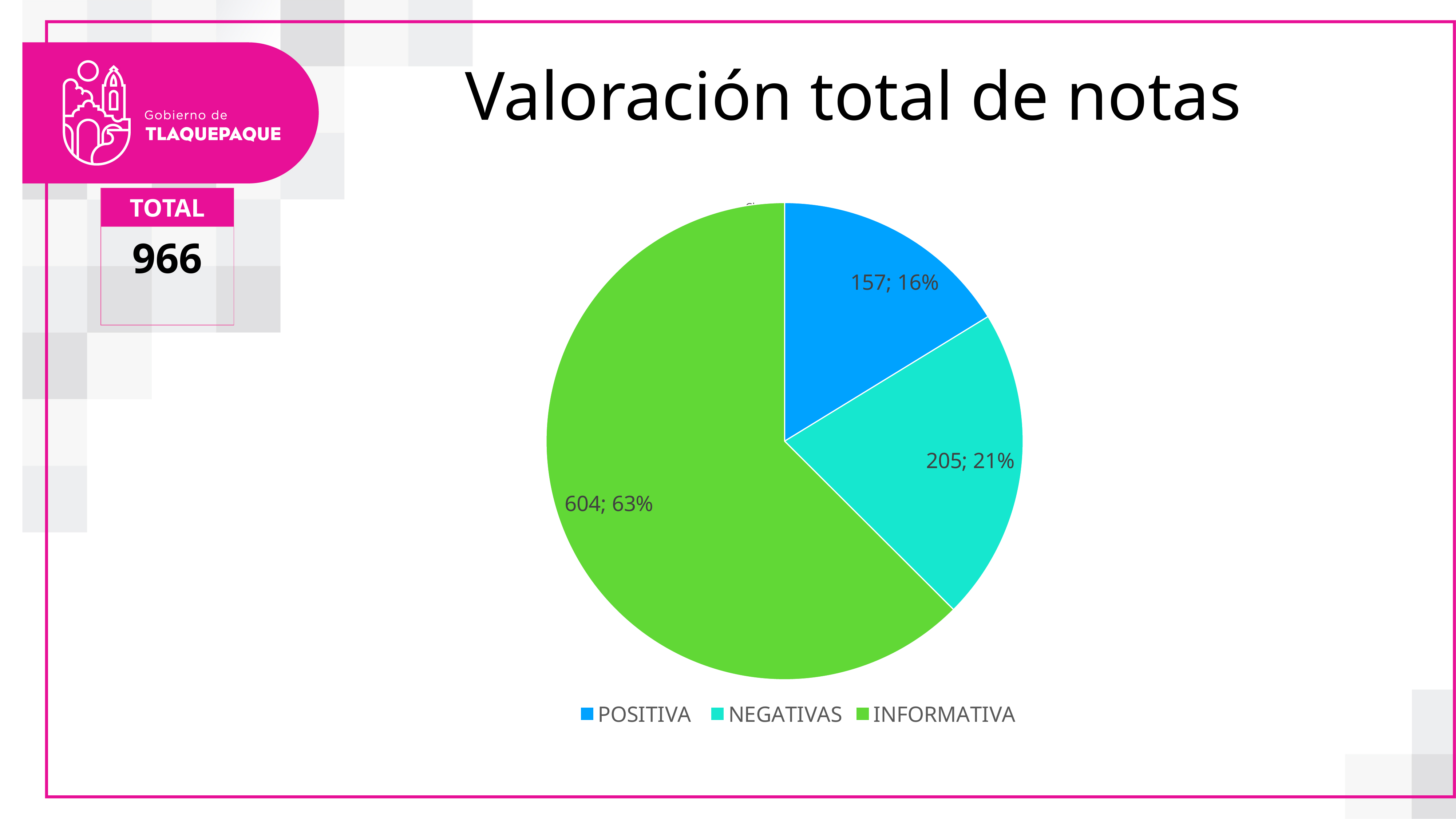
What kind of chart is shown on the slide? pie chart What is the value for INFORMATIVA? 604 Which category has the smallest slice? POSITIVA What is the difference between the values for NEGATIVAS and POSITIVA? 48 Which is larger, NEGATIVAS or POSITIVA? NEGATIVAS What is the title of the chart? Valoración total de notas What share of the pie does INFORMATIVA represent? 63% What is the value for NEGATIVAS? 205 What is the value for POSITIVA? 157 How many slices does the pie chart have? 3 What share of the pie does POSITIVA represent? 16% Which category has the largest slice? INFORMATIVA